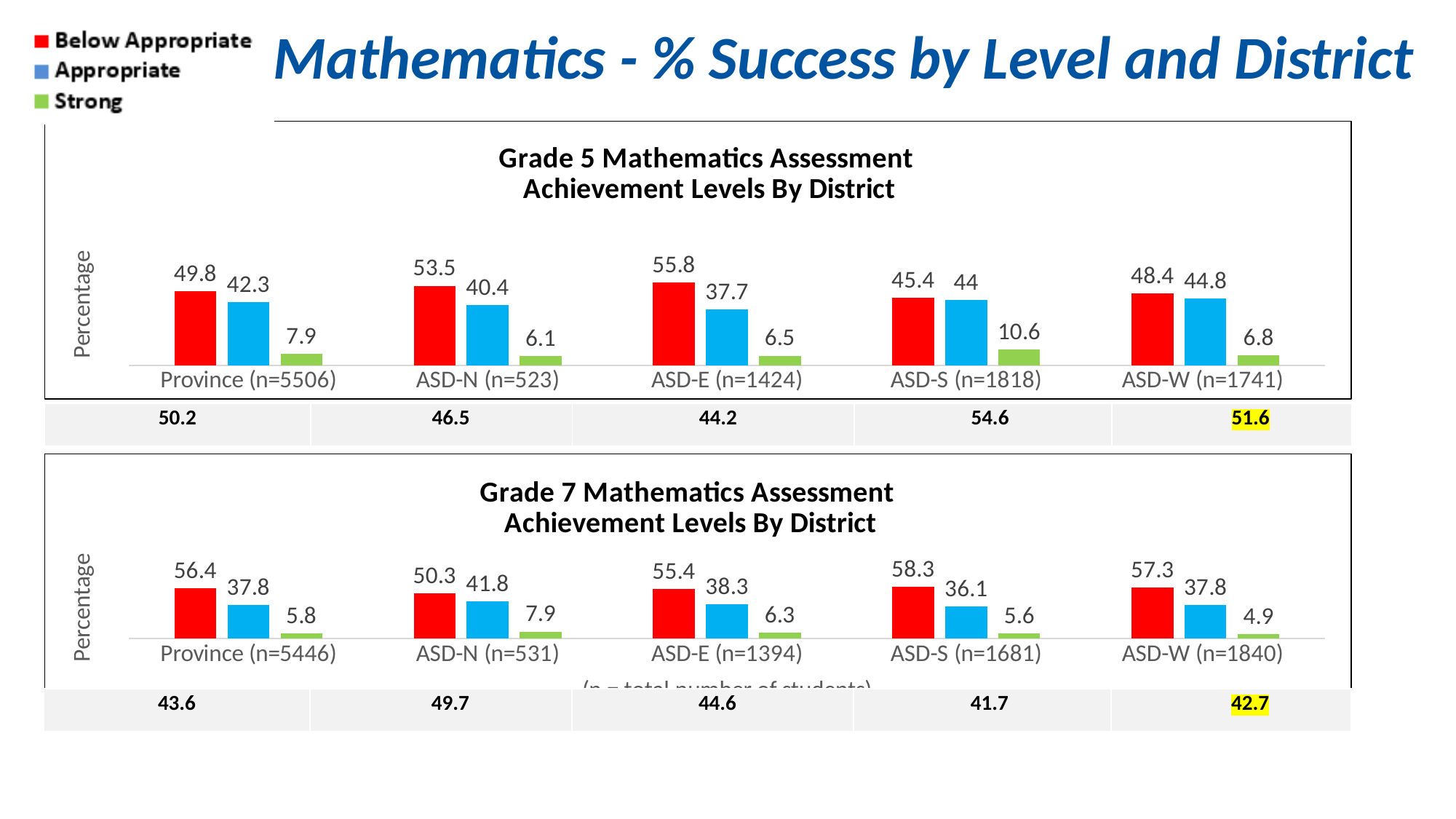
In the Grade 5 Mathematics Assessment chart, which district has the highest Strong value? ASD-S (n=1818) In the Grade 7 Mathematics Assessment chart, which is larger: the Appropriate value for ASD-N (n=531) or for ASD-S (n=1681)? ASD-N (n=531) Which colour represents the Strong series in the legend? Green What kind of chart is the Grade 7 Mathematics Assessment chart? Bar chart In the Grade 5 Mathematics Assessment chart, what is the Below Appropriate value for ASD-E (n=1424)? 55.8 In the Grade 7 Mathematics Assessment chart, which district has the lowest Strong value? ASD-W (n=1840) How many districts (categories) are shown in the Grade 5 Mathematics Assessment chart? 5 In the Grade 5 Mathematics Assessment chart, what is the Appropriate value for ASD-W (n=1741)? 44.8 How many series does the legend list for the charts? 3 In the Grade 7 Mathematics Assessment chart, what is the Strong value for ASD-N (n=531)? 7.9 In the Grade 7 Mathematics Assessment chart, what is the Below Appropriate value for ASD-S (n=1681)? 58.3 In the Grade 5 Mathematics Assessment chart, what is the difference between the Below Appropriate and Appropriate values for Province (n=5506)? 7.5